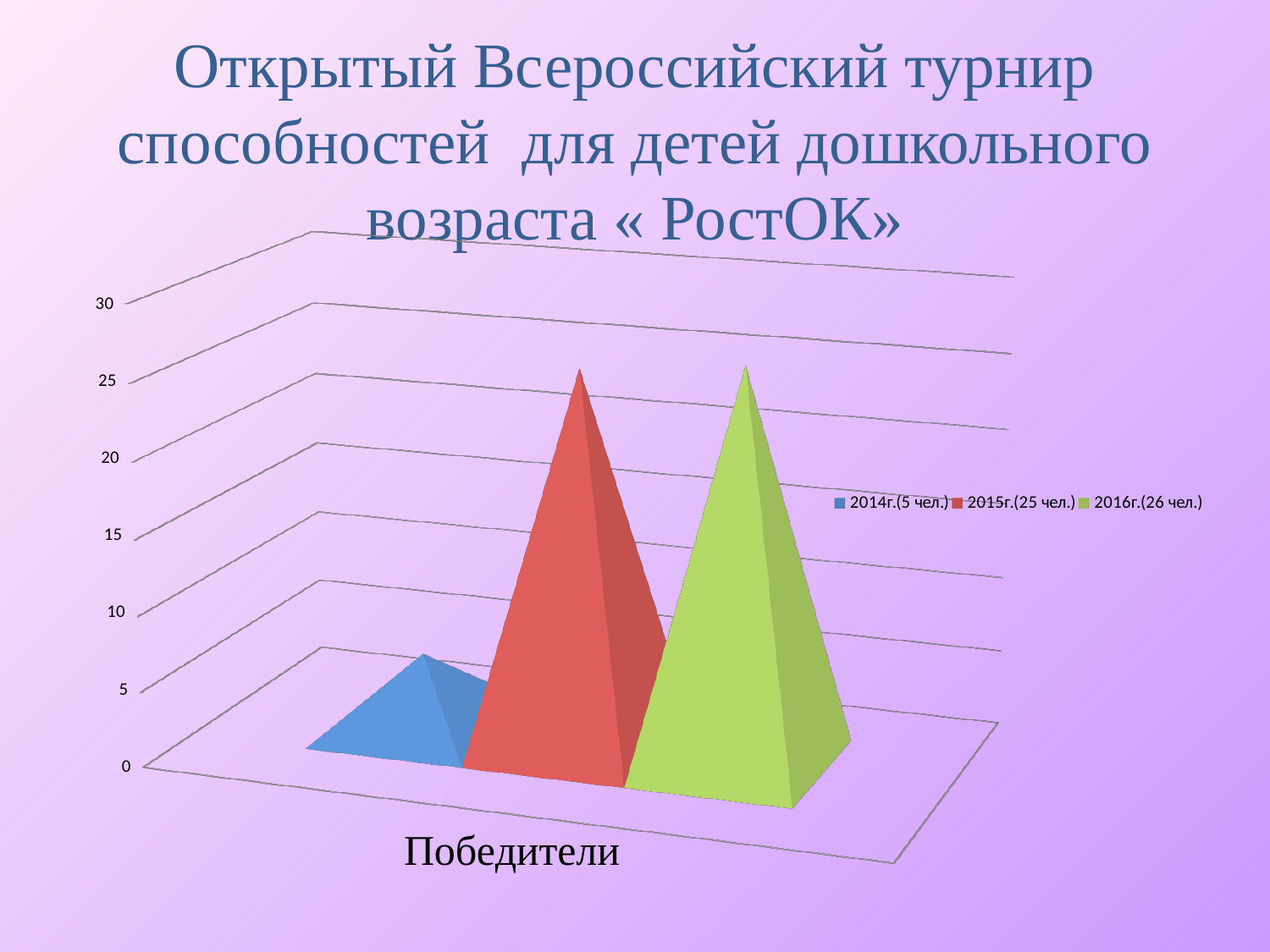
How many series does the legend list? 3 Which series has the lowest value? 2014г.(5 чел.) According to the legend, how many people does the 2014г. series represent? 5 чел. What is the difference between the 2015г. value and the 2014г. value? 20 Is the value for 2014г. greater or less than 10? less How many categories are shown on the x axis? 1 What is the category label shown on the x axis? Победители Which is larger, the value for 2014г. or the value for 2015г.? 2015г. According to the legend, how many people does the 2016г. series represent? 26 чел. Which series has the highest value? 2016г.(26 чел.) What kind of chart is shown on the slide? bar chart According to the legend, how many people does the 2015г. series represent? 25 чел.